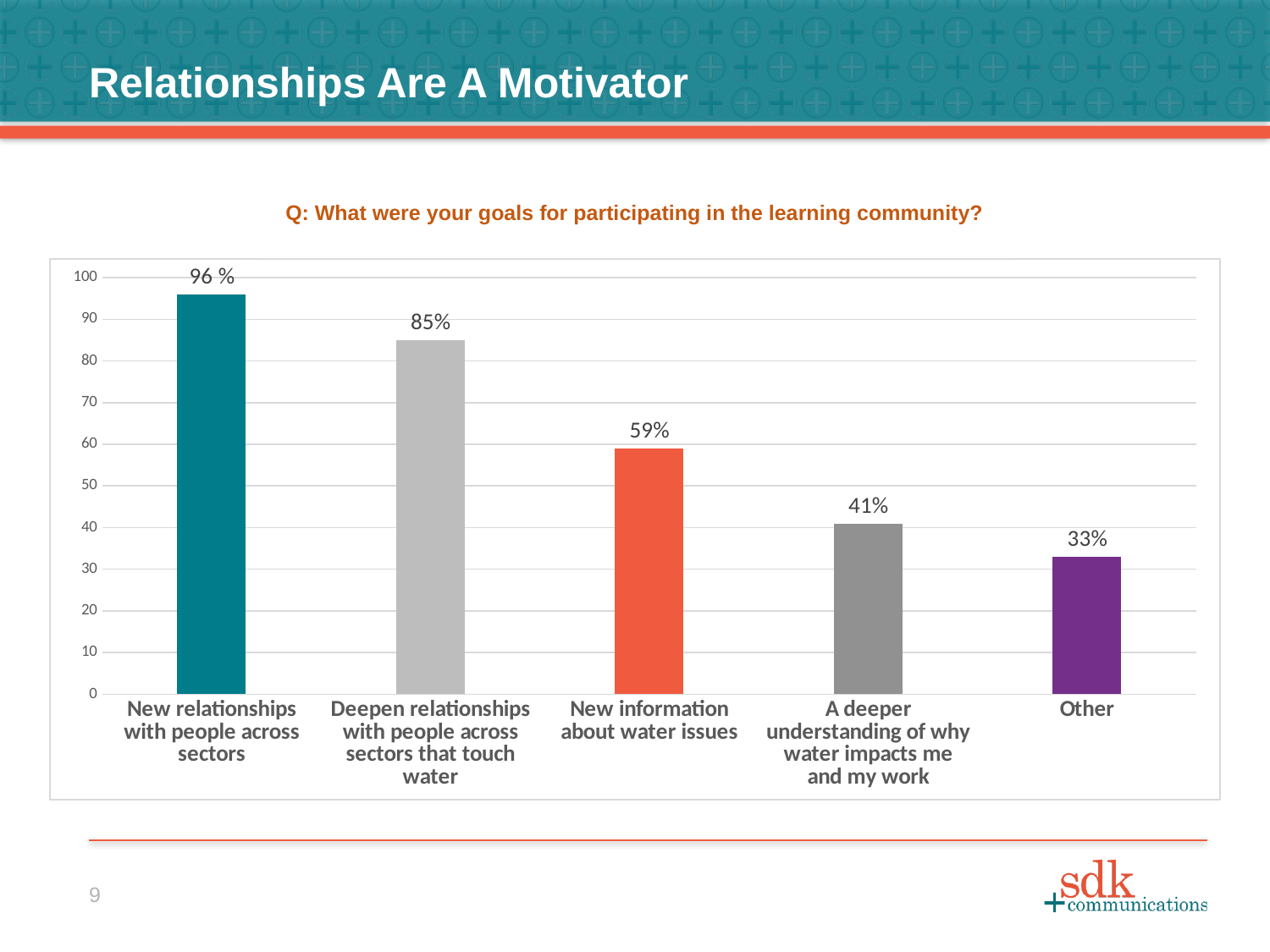
What question is the chart answering, as stated above it? Q: What were your goals for participating in the learning community? What percentage of respondents chose 'New relationships with people across sectors' as a goal? 96 % What is the value shown for 'New information about water issues'? 59% Is the value for 'Other' greater or less than 40? less Which goal has the highest percentage? New relationships with people across sectors What type of chart is shown on the slide? Bar chart How many categories are shown in the chart? 5 What percentage is shown for 'A deeper understanding of why water impacts me and my work'? 41% Which category has the lowest value? Other What is the difference between 'Deepen relationships with people across sectors that touch water' and 'Other'? 52 percentage points Do the values rise or fall moving from left to right across the categories? Fall Which is larger: 'New information about water issues' or 'A deeper understanding of why water impacts me and my work'? New information about water issues